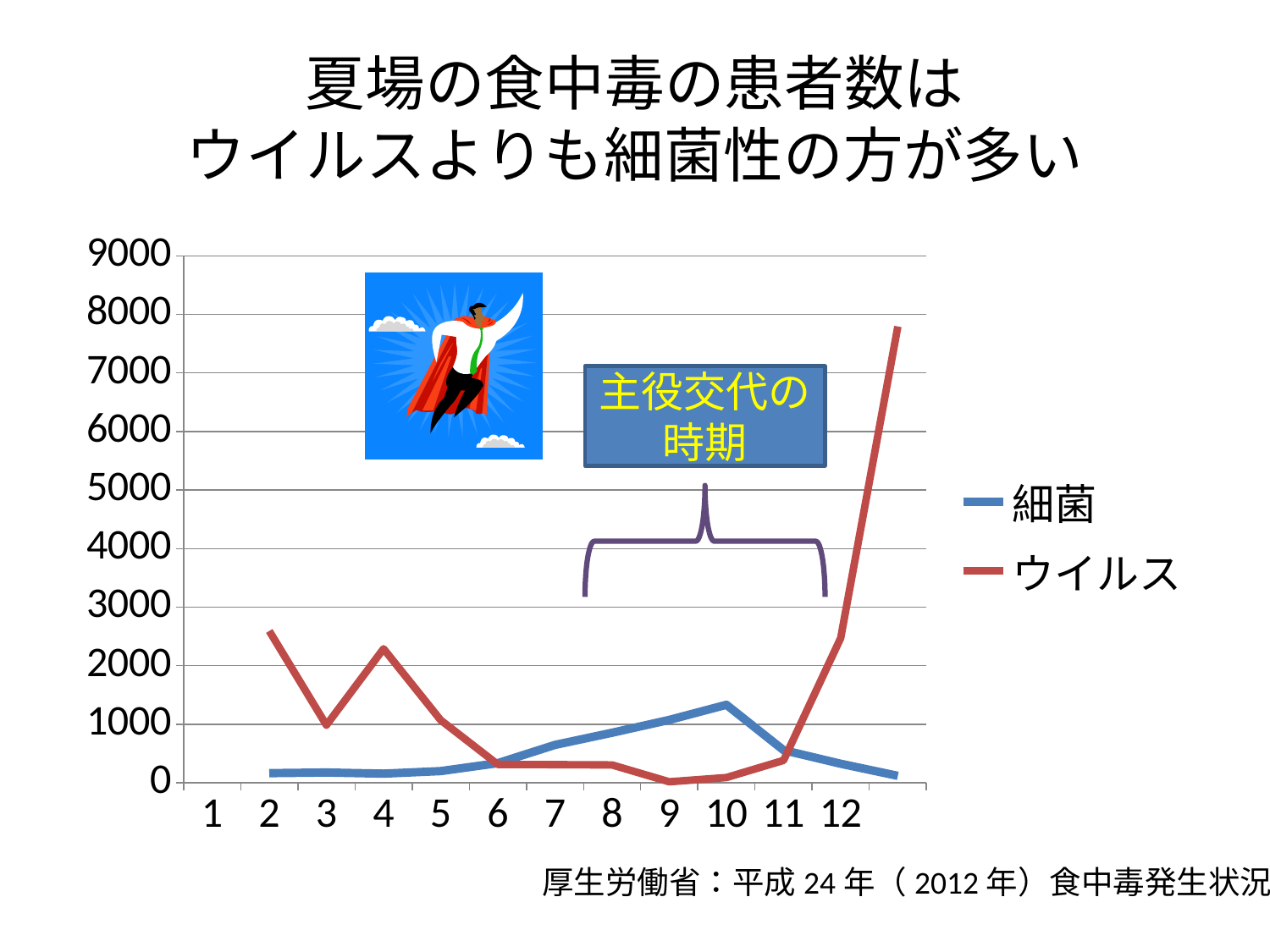
What kind of chart is shown on the slide? line chart What text is shown in the callout box above the bracket on the chart? 主役交代の時期 Which colour is used for the 細菌 series? blue At the right end of the x axis, which series has the higher value, 細菌 or ウイルス? ウイルス How many labelled categories are there on the x axis? 12 Is the peak of the 細菌 line greater or less than 1000? greater Is the highest value of the ウイルス line greater or less than 7000? greater Which series reaches the highest value on the chart? ウイルス Is the highest value of the 細菌 line greater or less than 2000? less Which series has the lower peak value? 細菌 Does the ウイルス line rise or fall toward the right end of the x axis? rise How many series does the legend list? 2